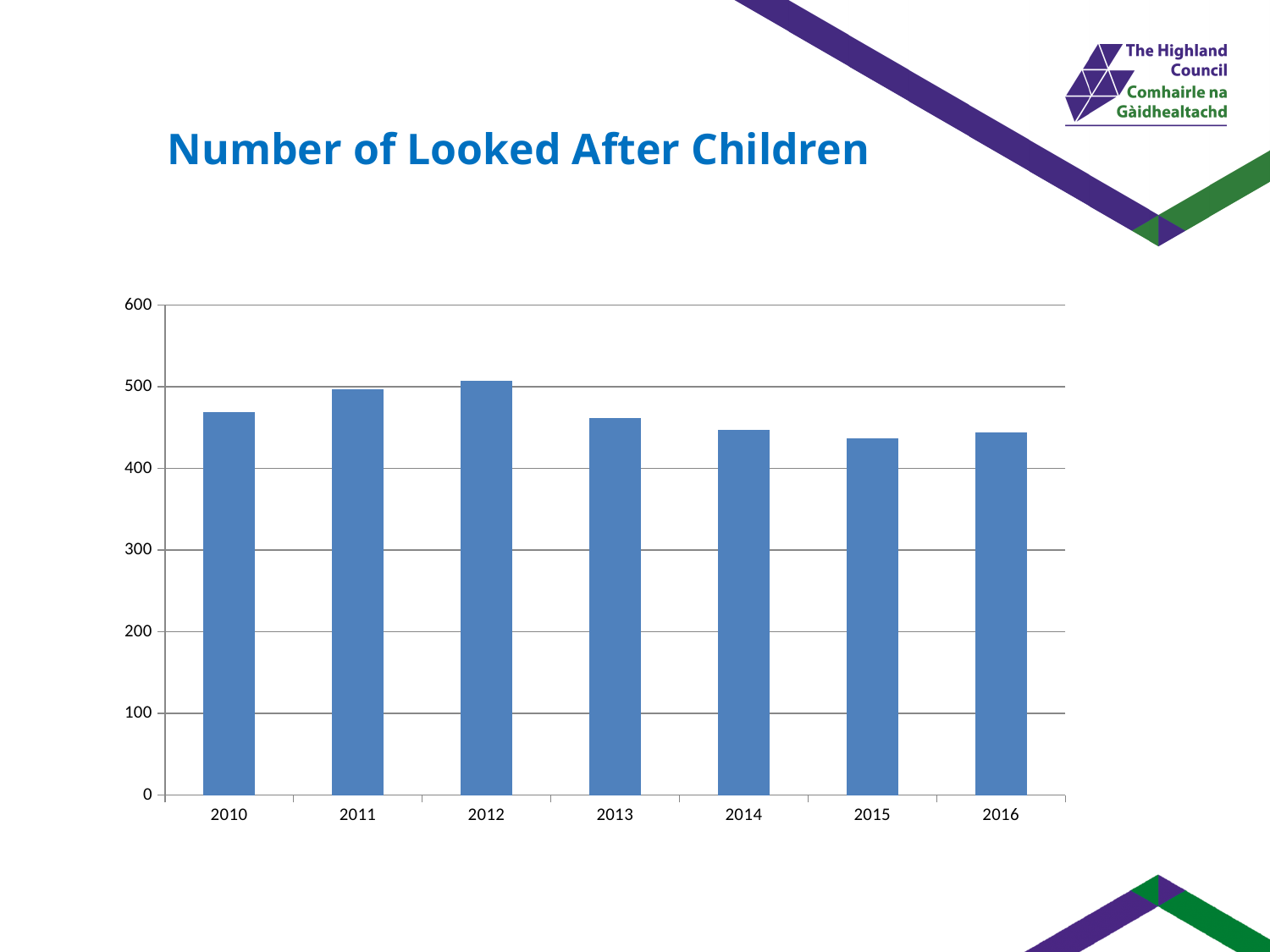
What colour are the bars in the chart? Blue Is the value for 2015 greater or less than 400? greater What kind of chart is shown on the slide? Bar chart Which is larger, the value for 2011 or the value for 2013? 2011 Is the value for 2012 greater or less than 500? greater Do the values rise or fall from 2012 to 2015? fall Which is larger, the value for 2010 or the value for 2014? 2010 Is the value for 2013 greater or less than 500? less Which year has the highest number of looked after children? 2012 What is the title of the chart? Number of Looked After Children How many years are shown on the x axis of the chart? 7